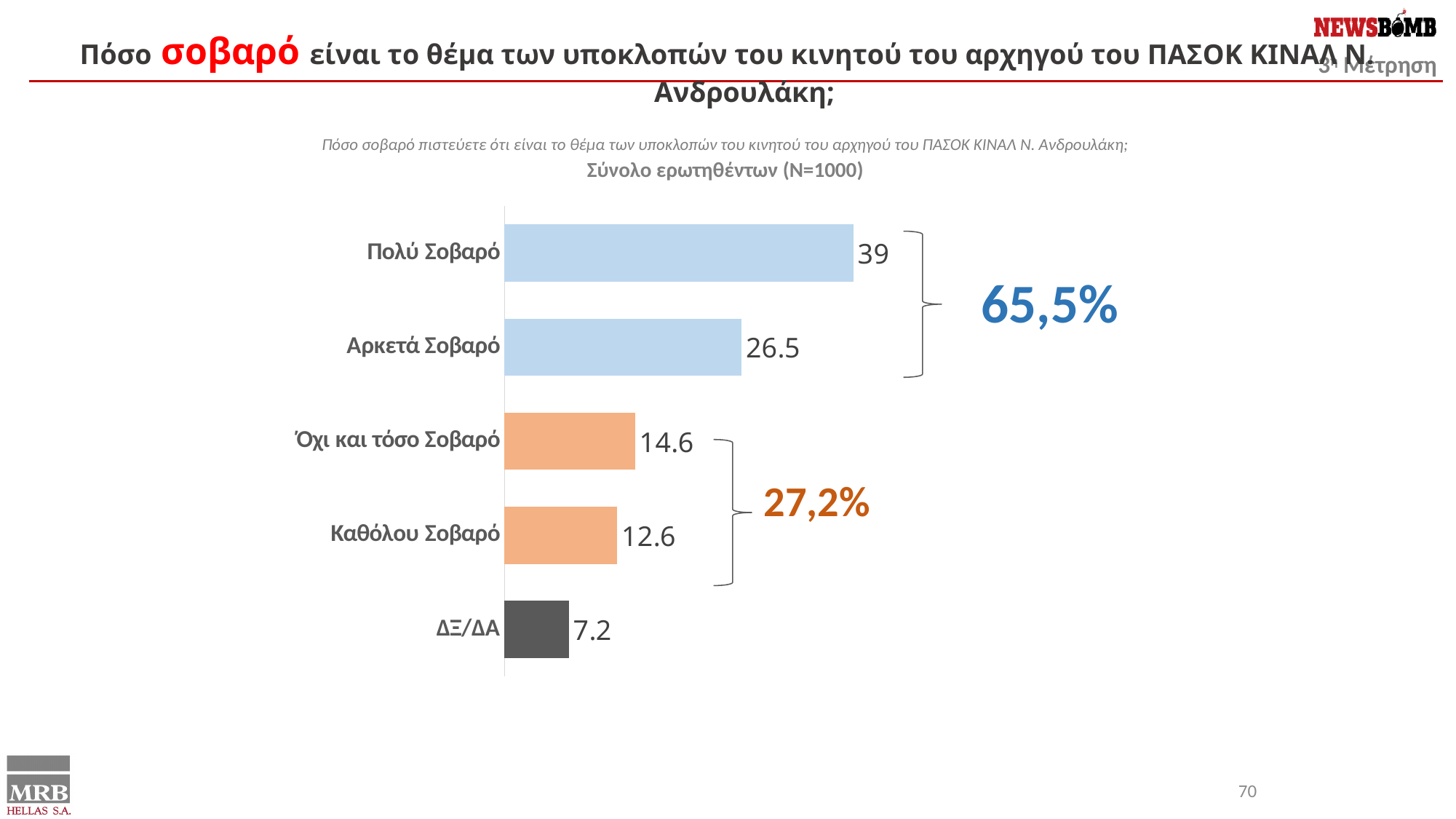
Which is larger, the value for Όχι και τόσο Σοβαρό or the value for Καθόλου Σοβαρό? Όχι και τόσο Σοβαρό What is the value for Πολύ Σοβαρό? 39 What combined percentage is shown next to the bracket grouping Πολύ Σοβαρό and Αρκετά Σοβαρό? 65,5% What is the value for ΔΞ/ΔΑ? 7.2 What is the value for Καθόλου Σοβαρό? 12.6 What is the value for Αρκετά Σοβαρό? 26.5 What kind of chart is shown on the slide? Bar chart What is the difference between the values for Πολύ Σοβαρό and Αρκετά Σοβαρό? 12.5 Which category has the highest value? Πολύ Σοβαρό Which category has the lowest value? ΔΞ/ΔΑ How many categories are shown in the chart? 5 What is the value for Όχι και τόσο Σοβαρό? 14.6